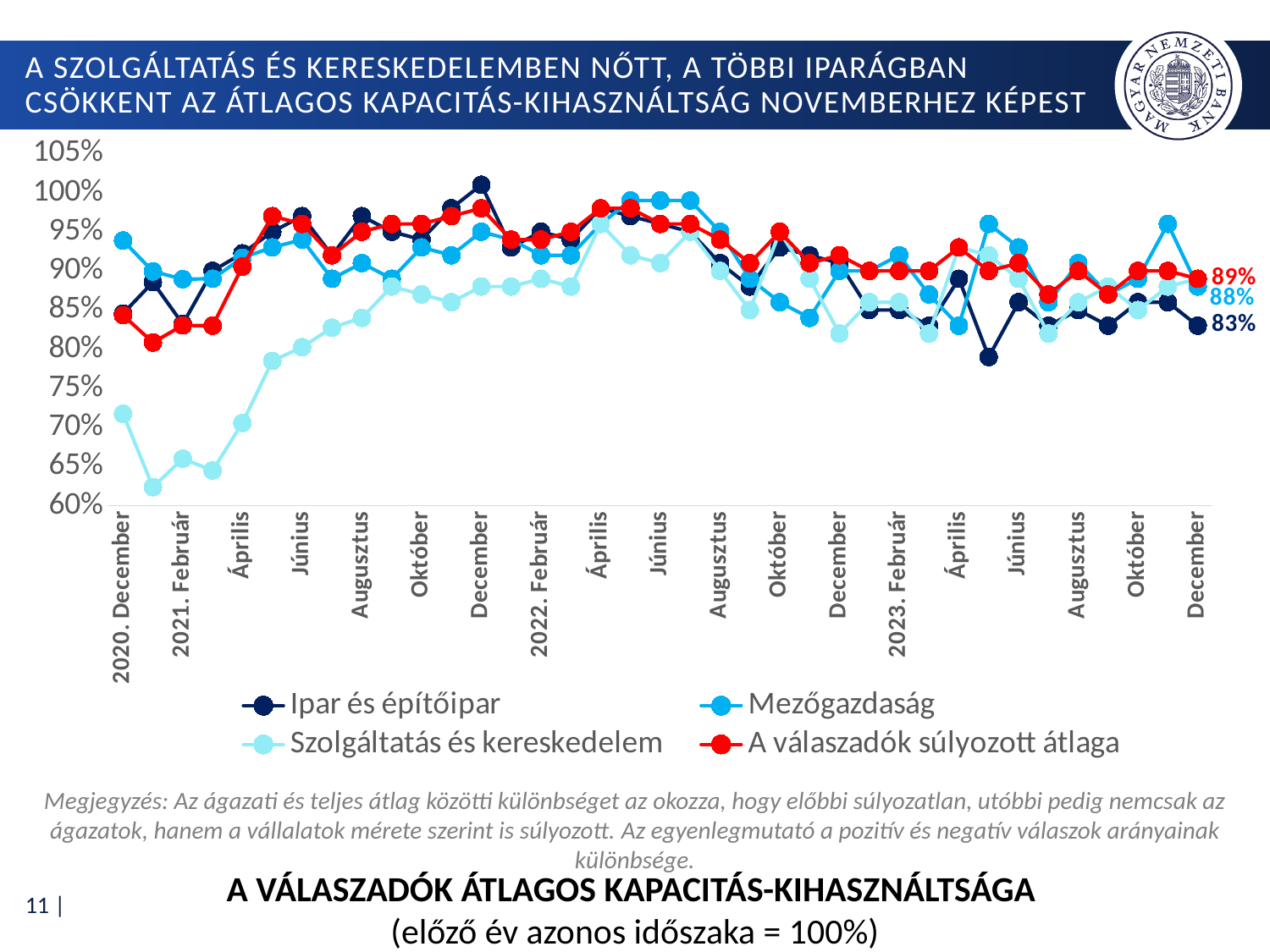
In December 2023, which is larger: Ipar és építőipar or A válaszadók súlyozott átlaga? A válaszadók súlyozott átlaga How many series does the legend list? 4 What kind of chart is shown on the slide? line chart What is the title of the chart shown below the legend? A válaszadók átlagos kapacitás-kihasználtsága (előző év azonos időszaka = 100%) Is the value for Szolgáltatás és kereskedelem in 2020 December greater or less than 75%? less Is the value for Ipar és építőipar in December 2021 greater or less than 95%? greater What is the value for Mezőgazdaság in December 2023, as labelled at the end of the line? 88% What is the difference between A válaszadók súlyozott átlaga (89%) and Ipar és építőipar (83%) in December 2023? 6 percentage points What is the value for Ipar és építőipar in December 2023, as labelled at the end of the line? 83% What is the value for A válaszadók súlyozott átlaga in December 2023, as labelled at the end of the line? 89% Which series has the lowest value in 2020 December? Szolgáltatás és kereskedelem Does the Szolgáltatás és kereskedelem line rise or fall between 2020 December and 2021 June? rise